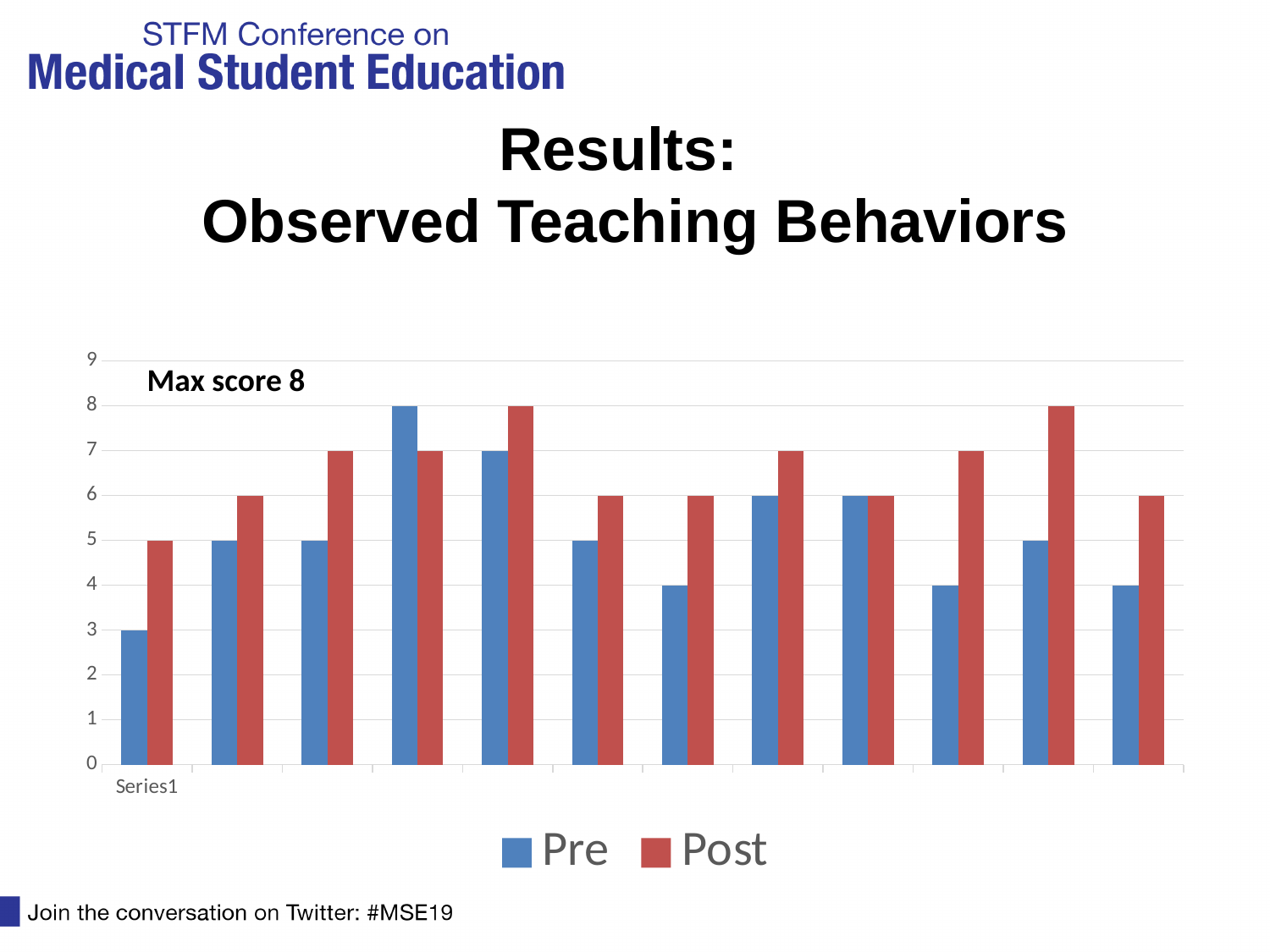
What kind of chart is shown on the slide? bar chart For Series1, which is larger, the Pre value or the Post value? Post What is the highest value reached by any Pre bar? 8 How many groups of bars are plotted on the chart? 12 What is the highest value reached by any Post bar? 8 What is the Pre value for Series1? 3 What annotation is printed in the top-left corner of the plot area? Max score 8 For Series1, how much higher is the Post value than the Pre value? 2 What are the two series named in the legend? Pre and Post How many series does the legend list? 2 What is the lowest value reached by any Pre bar? 3 What is the Post value for Series1? 5